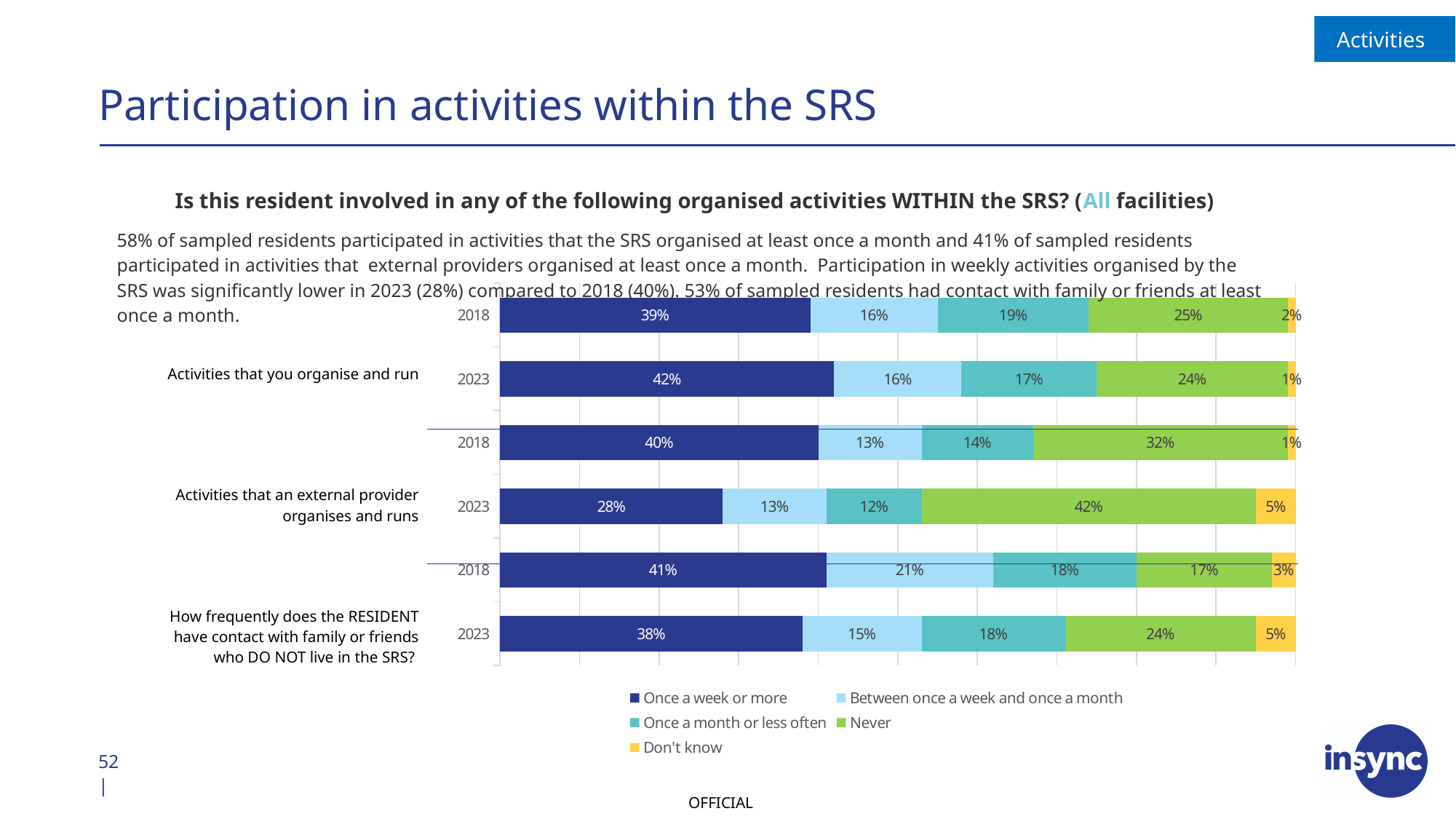
What kind of chart is shown on the slide? Stacked bar chart By how many percentage points did the 'Once a week or more' value for activities that an external provider organises and runs fall from 2018 to 2023? 12 percentage points What is the 'Between once a week and once a month' value for contact with family or friends who do not live in the SRS in 2018? 21% What is the 'Never' value for activities that an external provider organises and runs in 2023? 42% Which bar has the highest 'Once a week or more' value? Activities that you organise and run, 2023 What percentage of residents participated 'Once a week or more' in activities that you organise and run in 2023? 42% How many bars are plotted in the chart? 6 Which is larger: the 'Never' value for activities that you organise and run in 2018 or in 2023? 2018 Which bar has the lowest 'Once a week or more' value? Activities that an external provider organises and runs, 2023 What is the 'Don't know' value for contact with family or friends who do not live in the SRS in 2023? 5% How many series does the legend list? 5 Which legend entry is shown in yellow? Don't know